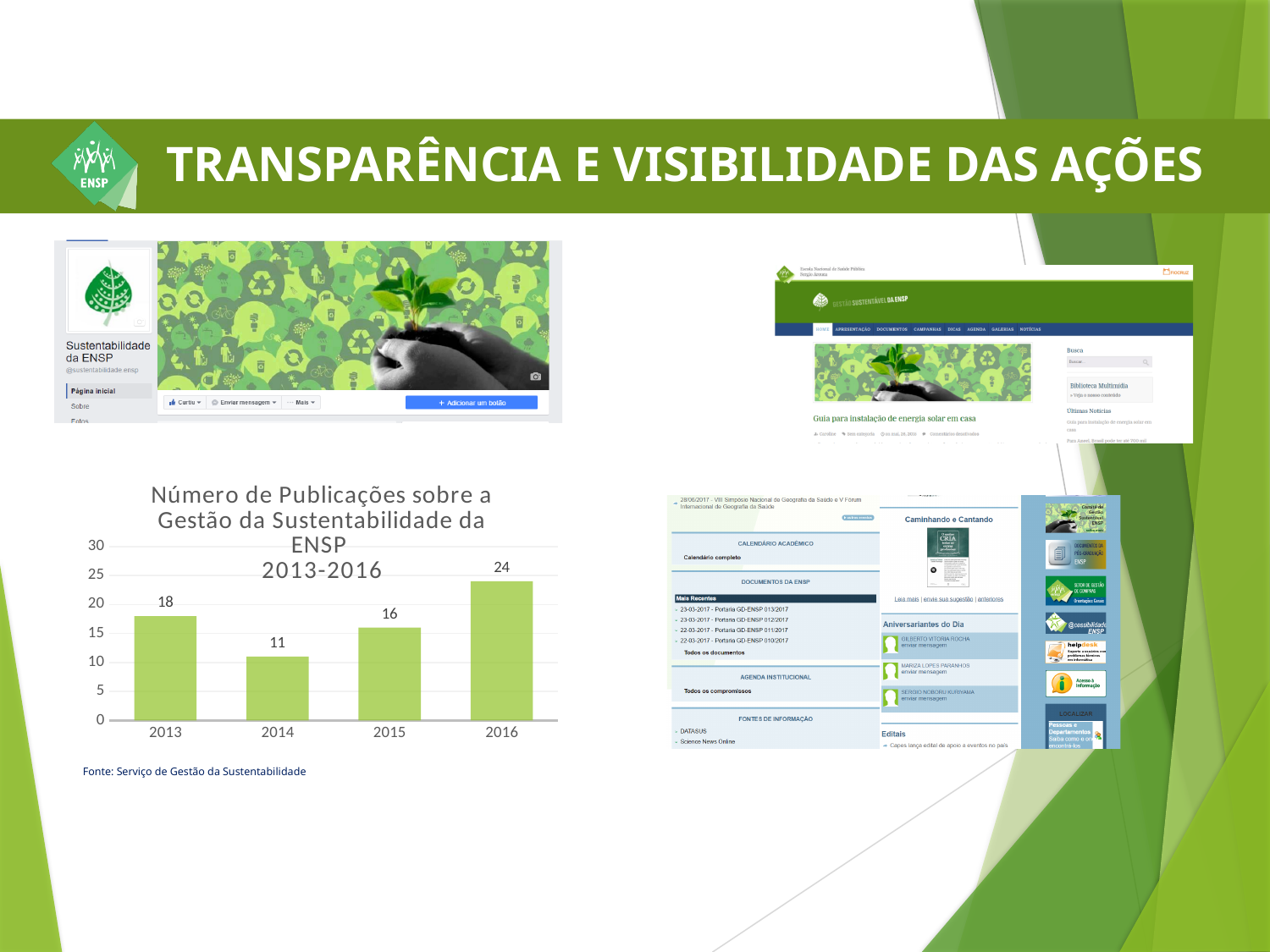
Is the value for 2016 greater or less than 20? greater What is the number of publications in 2014? 11 What is the number of publications in 2016? 24 How many years are shown on the x axis of the chart? 4 Which year had more publications, 2013 or 2015? 2013 What is the difference between the number of publications in 2016 and 2014? 13 What is the source cited below the chart? Serviço de Gestão da Sustentabilidade Which year has the highest number of publications? 2016 Which year has the lowest number of publications? 2014 What is the number of publications in 2013? 18 What is the number of publications in 2015? 16 What kind of chart is used to show the number of publications? bar chart